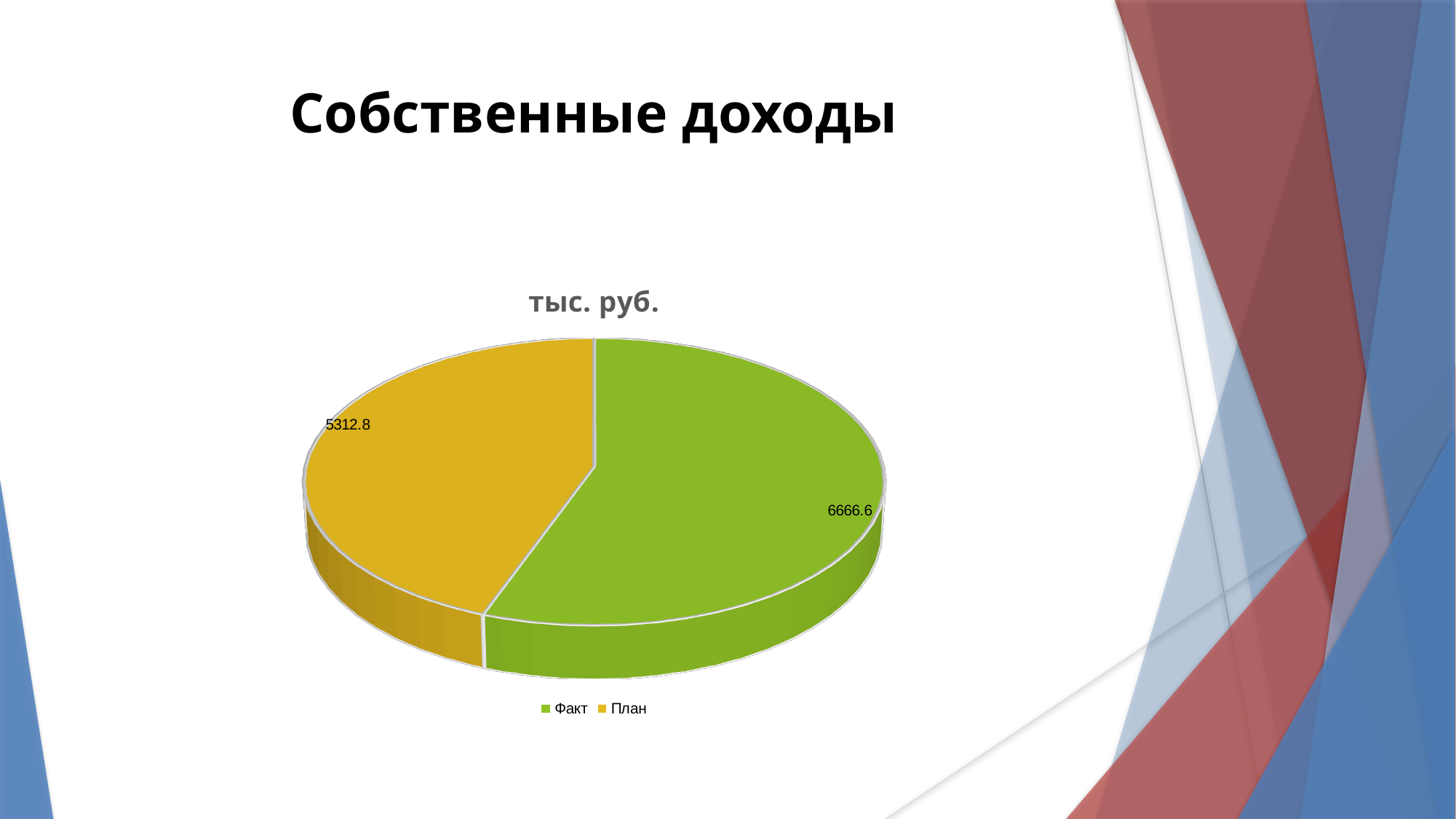
What colour is the Факт slice in the pie chart? Green What type of chart is shown on the slide? Pie chart What is the total of the two values shown in the pie chart? 11979.4 How many entries does the legend of the pie chart list? 2 Which slice of the pie chart is the largest? Факт What is the title of the chart on the slide? тыс. руб. What is the value of the Факт slice in the pie chart? 6666.6 Which slice of the pie chart is the smallest? План What is the value of the План slice in the pie chart? 5312.8 How many slices does the pie chart have? 2 What is the difference between the Факт and План values in the pie chart? 1353.8 Which is larger in the pie chart, Факт or План? Факт